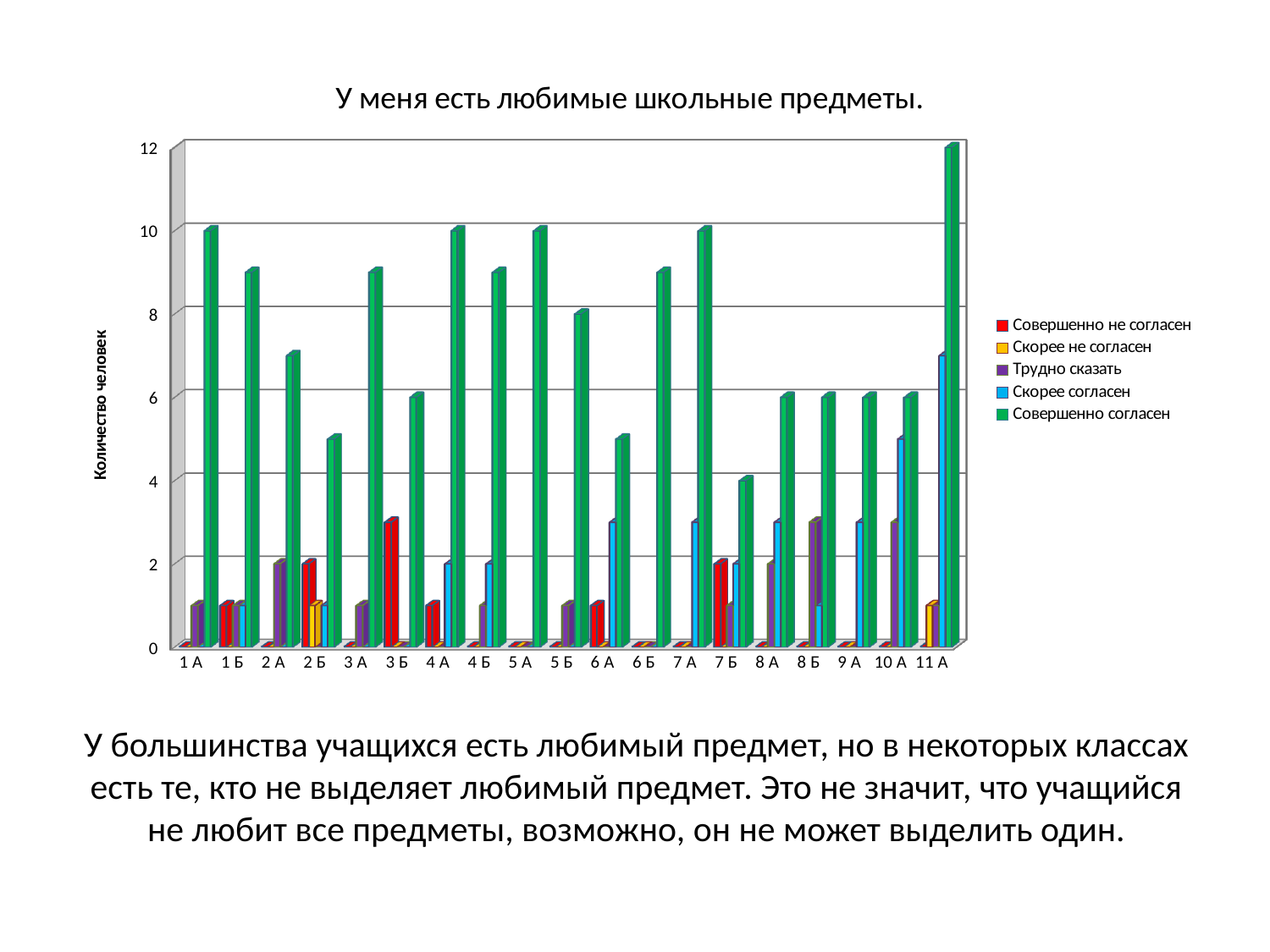
Which class has the lowest value for 'Совершенно согласен'? 7 Б Which is larger, the 'Скорее согласен' value for class 11 А or for class 10 А? 11 А What is the label of the vertical axis? Количество человек Which class has the highest value for 'Совершенно согласен'? 11 А Is the value for 'Совершенно согласен' in class 7 Б greater or less than 6? less What kind of chart is shown on the slide? bar chart How many series does the legend list? 5 What is the title of the chart? У меня есть любимые школьные предметы. Is the value for 'Совершенно согласен' in class 11 А greater or less than 10? greater How many class categories are shown on the x axis? 19 Is the value for 'Скорее согласен' in class 11 А greater or less than 6? greater